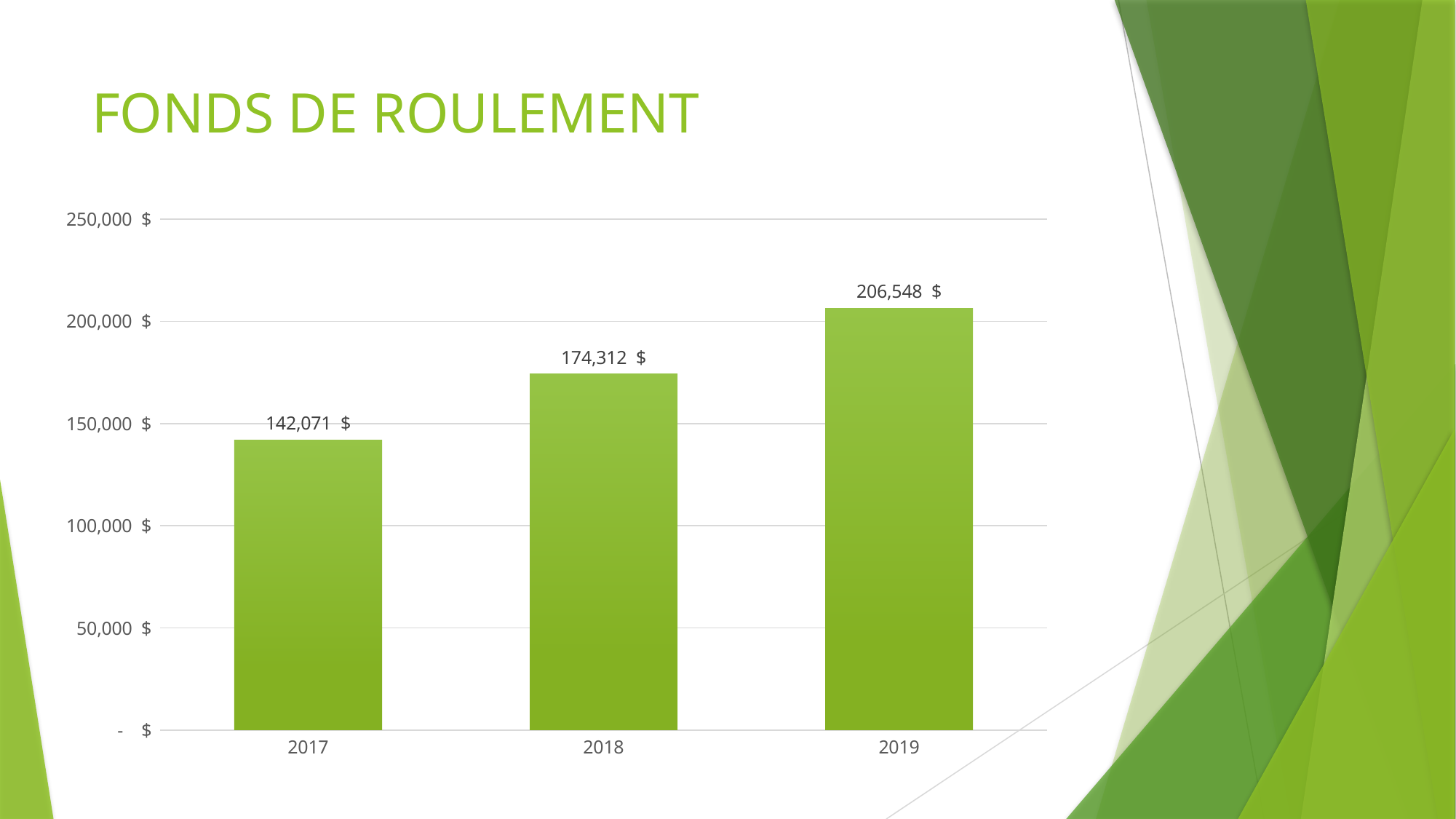
What is the difference between the values for 2019 and 2017? 64,477 $ Which year has the lowest value? 2017 What is the difference between the values for 2018 and 2017? 32,241 $ What is the value for 2018? 174,312 $ Which is larger, the value for 2018 or the value for 2019? 2019 What is the value for 2019? 206,548 $ Which year has the highest value? 2019 How many years are shown on the x axis? 3 What kind of chart is shown on the slide? bar chart What is the value for 2017? 142,071 $ Do the values rise or fall from 2017 to 2019? rise Is the value for 2019 greater or less than 200,000 $? greater